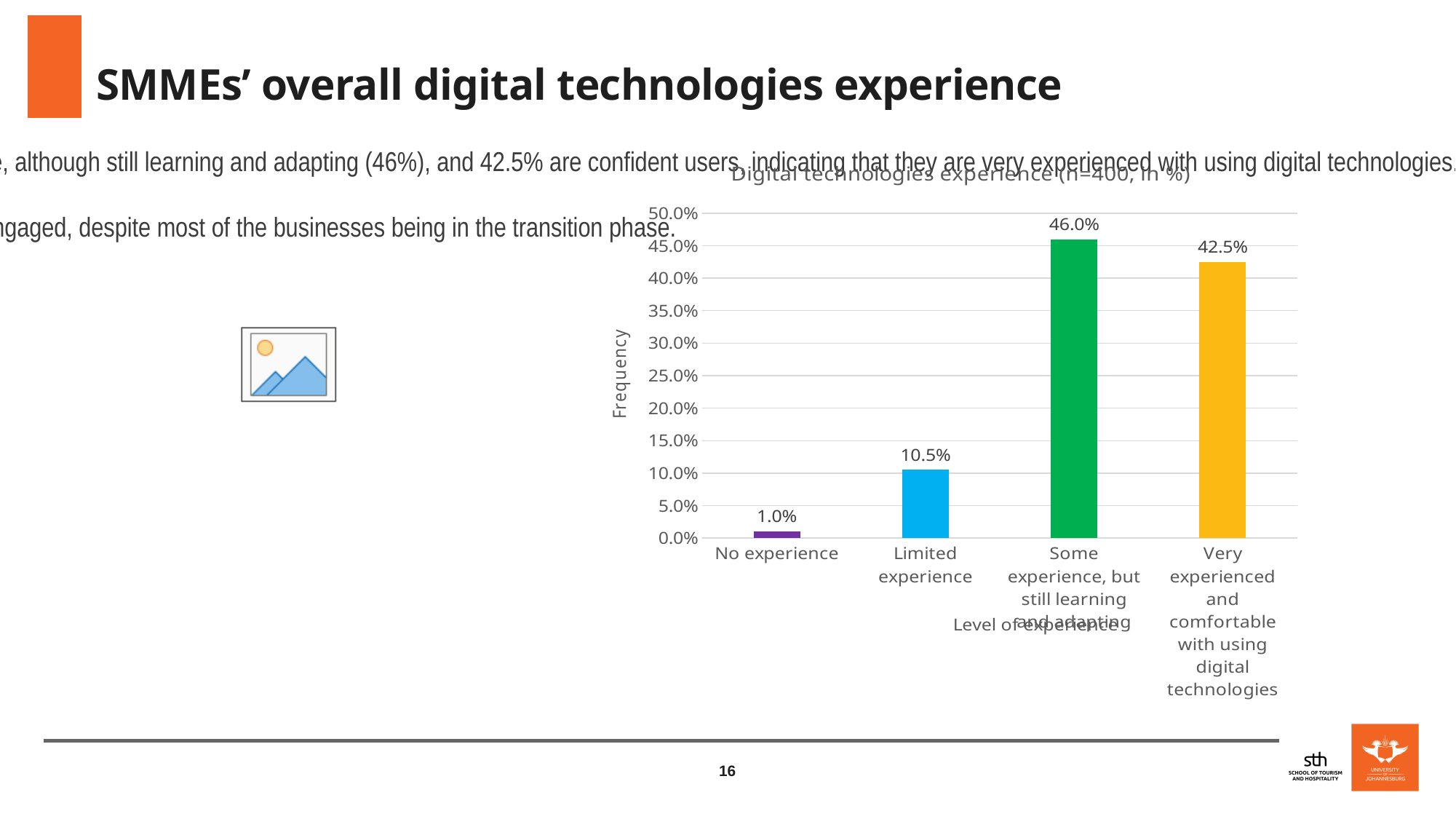
What is the difference between the values for "Some experience, but still learning and adapting" and "Very experienced and comfortable with using digital technologies"? 3.5% What is the value for "Very experienced and comfortable with using digital technologies"? 42.5% Which category has the lowest value? No experience What is the difference between the values for "Limited experience" and "No experience"? 9.5% What is the value for "Some experience, but still learning and adapting"? 46.0% What kind of chart is shown on the slide? Bar chart Which is larger, the value for "Limited experience" or the value for "Very experienced and comfortable with using digital technologies"? Very experienced and comfortable with using digital technologies What is the label of the vertical axis? Frequency What is the value for "No experience"? 1.0% What is the value for "Limited experience"? 10.5% How many categories are shown on the x axis? 4 Which category has the highest value? Some experience, but still learning and adapting